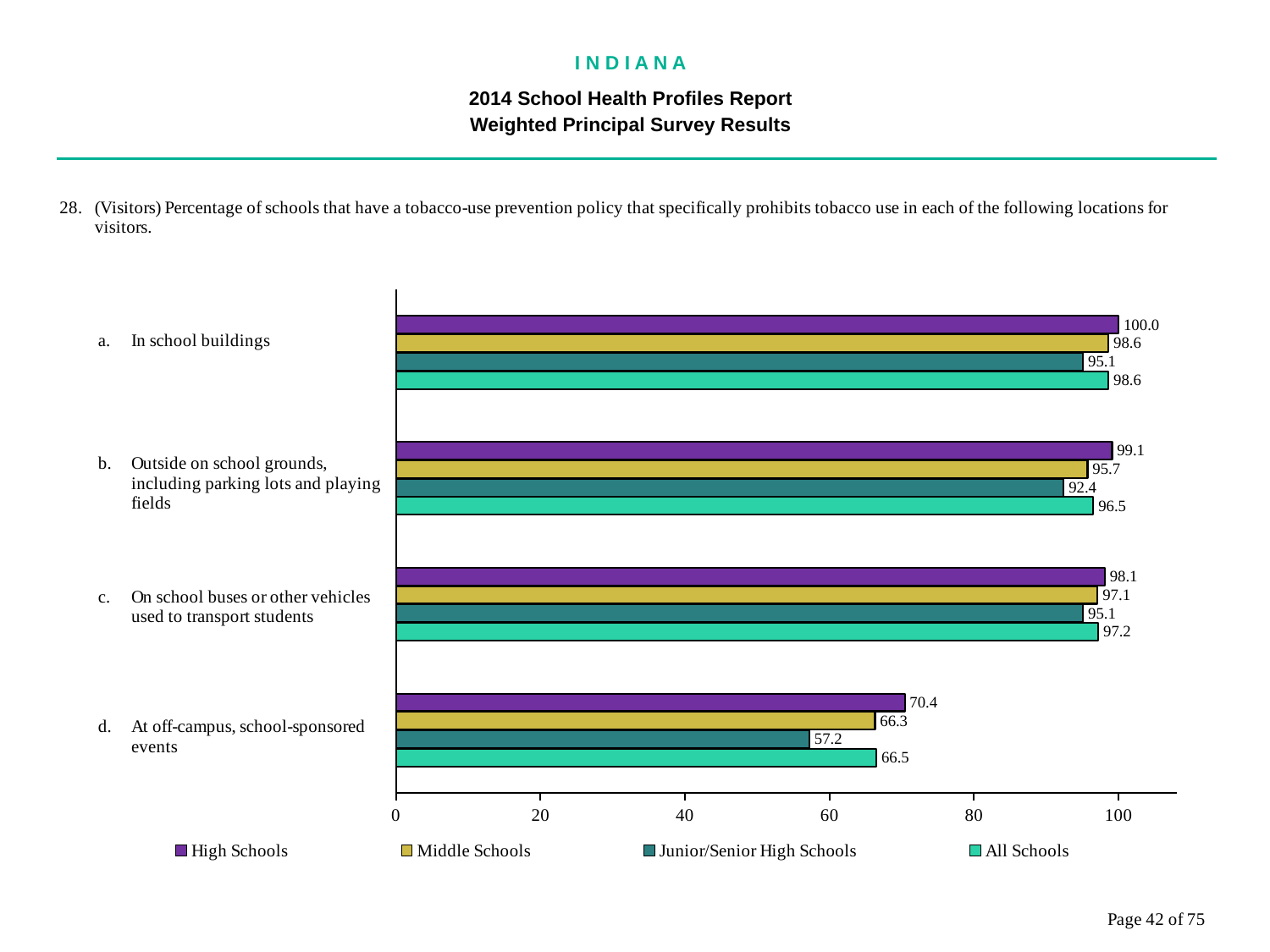
What kind of chart is shown on the slide? Bar chart What is the value for Middle Schools for 'On school buses or other vehicles used to transport students'? 97.1 For 'Outside on school grounds, including parking lots and playing fields', which is larger: the Middle Schools value or the Junior/Senior High Schools value? Middle Schools What is the value for All Schools for 'Outside on school grounds, including parking lots and playing fields'? 96.5 How many location categories are shown in the chart? 4 What is the difference between the High Schools and Junior/Senior High Schools values for 'At off-campus, school-sponsored events'? 13.2 Is the value for Middle Schools for 'At off-campus, school-sponsored events' greater or less than 80? less What is the value for Junior/Senior High Schools for 'At off-campus, school-sponsored events'? 57.2 How many series does the legend list? 4 What is the value for High Schools for 'In school buildings'? 100.0 Which location has the highest value for Junior/Senior High Schools? In school buildings and On school buses or other vehicles used to transport students (tied at 95.1) Which location has the lowest value for High Schools? At off-campus, school-sponsored events